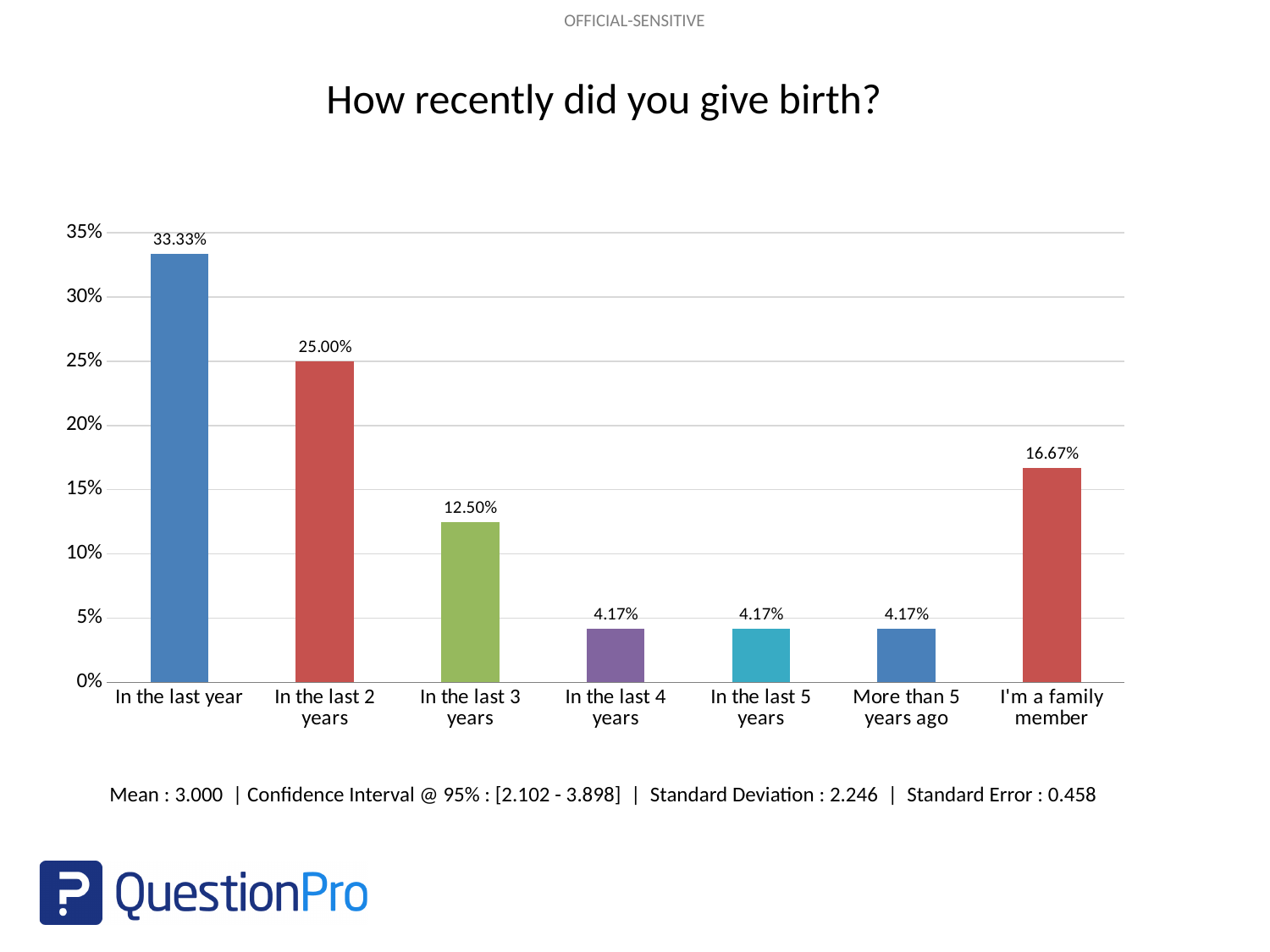
What is the title of the chart? How recently did you give birth? What is the difference between "I'm a family member" and "In the last 3 years"? 4.17% Is the value for "In the last 2 years" greater or less than 20%? greater What is the value for "In the last 3 years"? 12.50% What is the value for "I'm a family member"? 16.67% What is the value for "In the last year"? 33.33% What is the difference between "In the last year" and "In the last 2 years"? 8.33% Which category has the highest value? In the last year Which is larger, "In the last 3 years" or "I'm a family member"? I'm a family member How many categories are shown on the x axis? 7 What kind of chart is shown on the slide? Bar chart What is the value for "In the last 2 years"? 25.00%